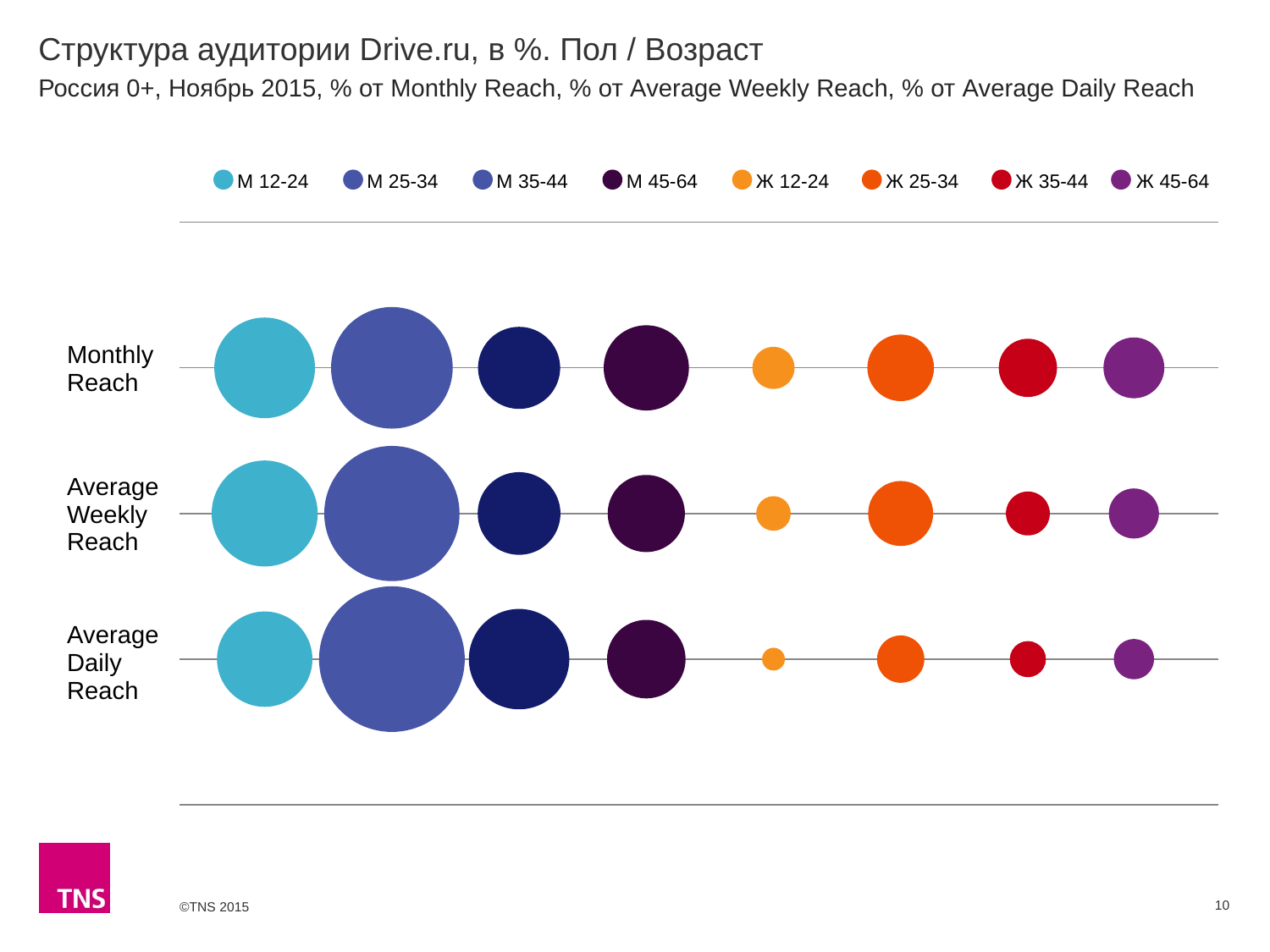
How many series does the legend list? 8 Which audience group has the largest bubble in the Average Daily Reach row? М 25-34 How many reach categories (rows) are plotted on the chart? 3 What is the label of the first series in the legend? М 12-24 In the Monthly Reach row, which is larger: the bubble for М 45-64 or the bubble for Ж 45-64? М 45-64 Which audience group has the largest bubble in the Monthly Reach row? М 25-34 Which audience group has the smallest bubble in the Average Daily Reach row? Ж 12-24 What kind of chart is shown on the slide? Bubble chart What is the title of the chart on the slide? Структура аудитории Drive.ru, в %. Пол / Возраст In the Average Daily Reach row, which is larger: the bubble for Ж 25-34 or the bubble for Ж 12-24? Ж 25-34 In the Average Weekly Reach row, which is larger: the bubble for М 12-24 or the bubble for Ж 12-24? М 12-24 Which audience group has the smallest bubble in the Monthly Reach row? Ж 12-24